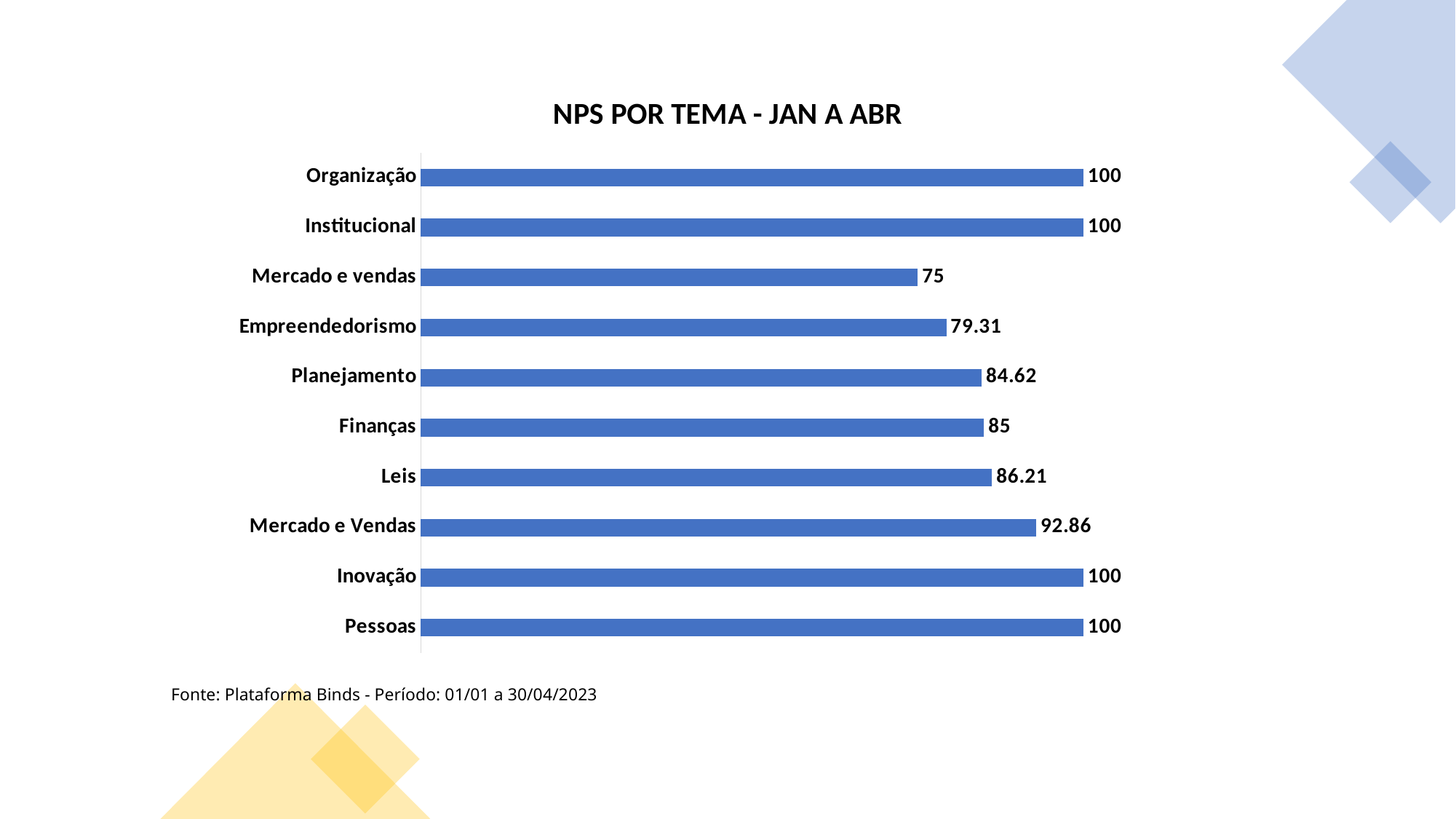
What is the NPS value for Inovação? 100 What kind of chart is shown on the slide? Bar chart Which category has the lowest NPS value? Mercado e vendas What is the NPS value for Finanças? 85 How many categories have an NPS value of 100? 4 What is the NPS value for Leis? 86.21 Which has a higher NPS value, Leis or Planejamento? Leis How many categories are shown on the chart? 10 What is the highest NPS value shown on the chart? 100 What is the difference between the NPS values for Leis and Finanças? 1.21 What is the NPS value for Empreendedorismo? 79.31 What is the NPS value for Planejamento? 84.62